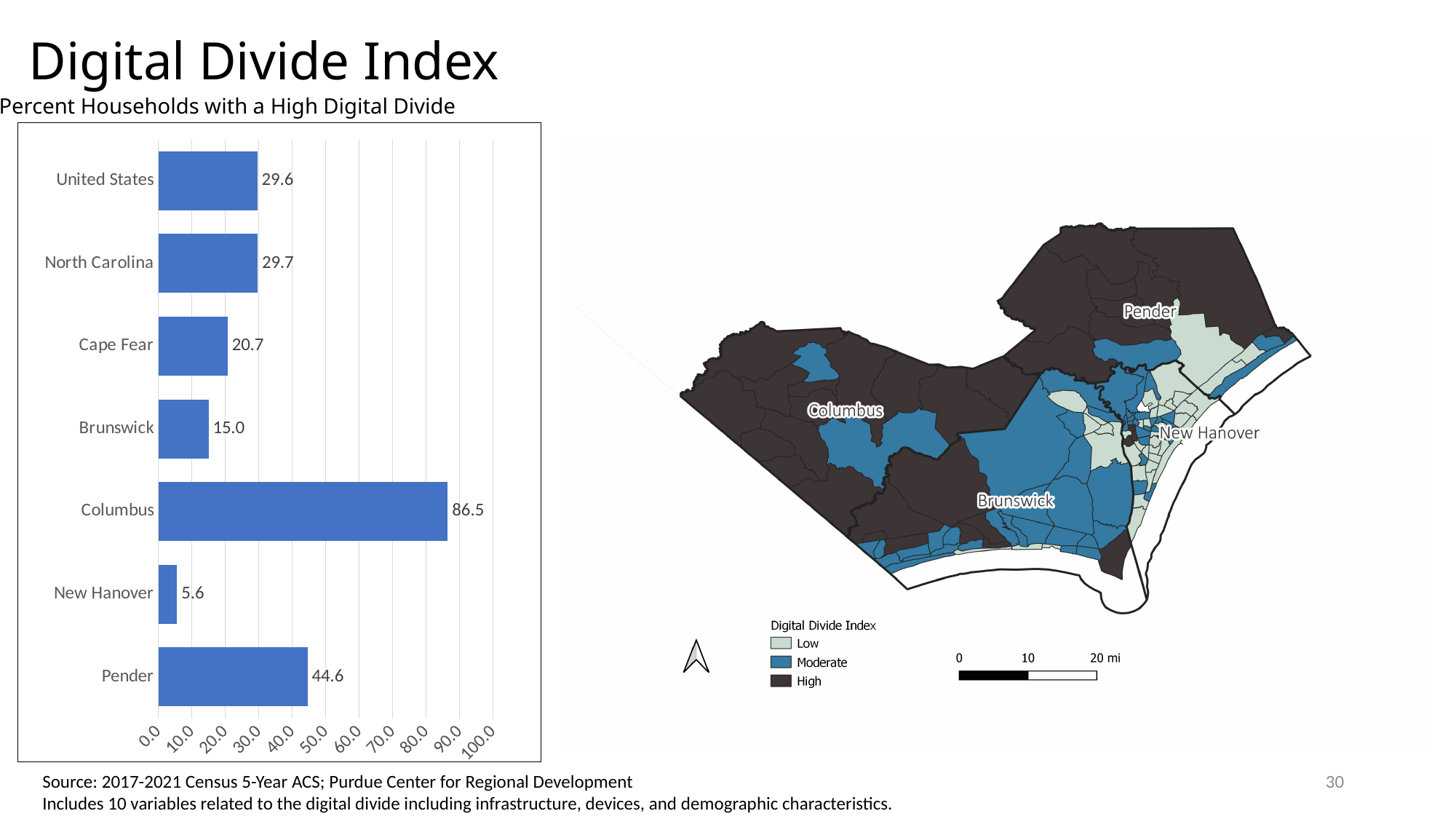
Which category has the lowest value in the bar chart? New Hanover What kind of chart is shown on the left of the slide? Bar chart Which is larger in the bar chart, the value for Pender or the value for Brunswick? Pender What is the difference between the values for Brunswick and New Hanover in the bar chart? 9.4 How many categories are shown in the bar chart? 7 What is the difference between the values for Columbus and Pender in the bar chart? 41.9 What is the value for Cape Fear in the bar chart? 20.7 What is the value for Columbus in the bar chart? 86.5 Which category has the highest value in the bar chart? Columbus What is the title of the bar chart? Percent Households with a High Digital Divide What is the value for Pender in the bar chart? 44.6 What is the value for New Hanover in the bar chart? 5.6